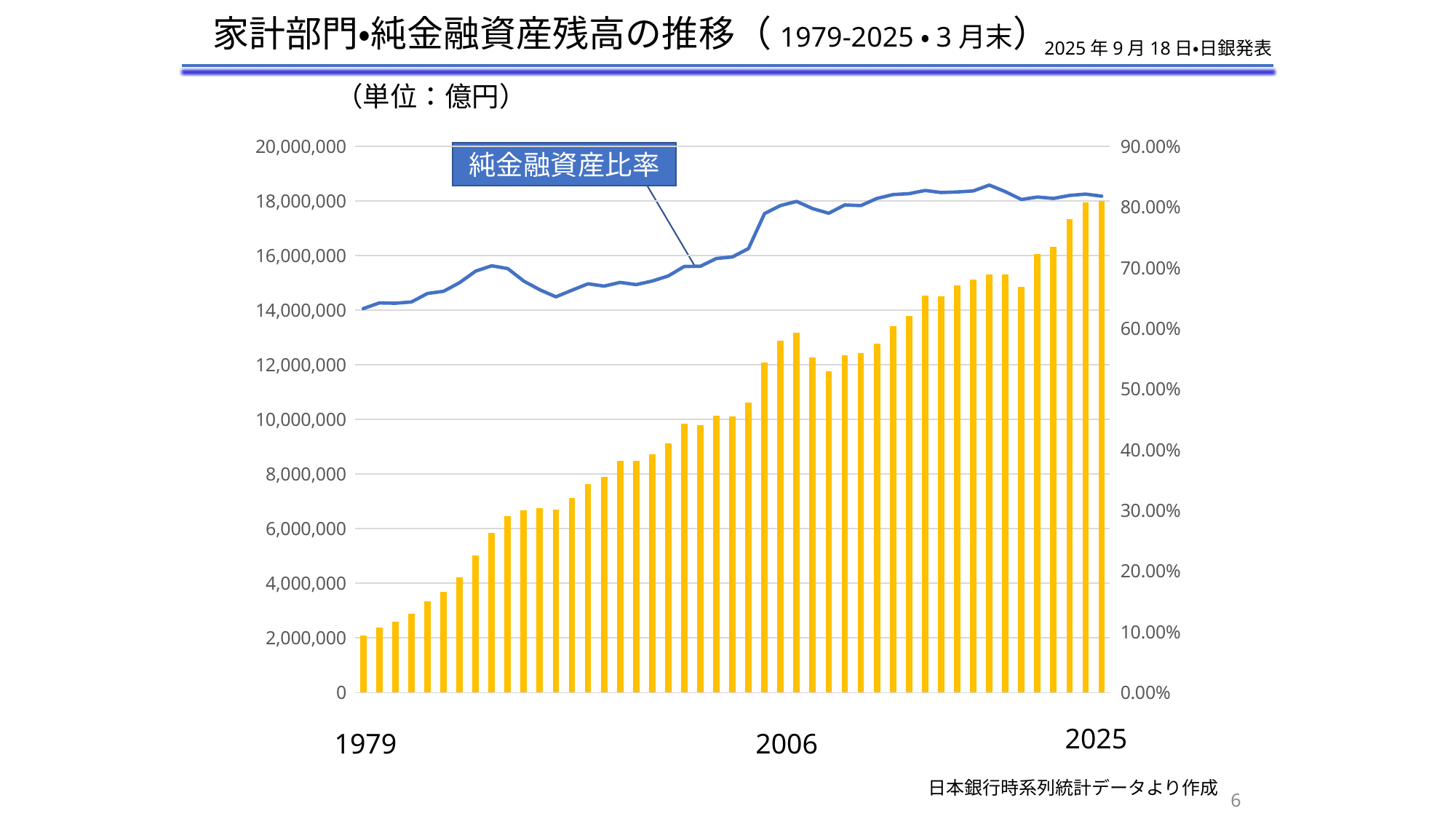
What is the title of the chart? 家計部門•純金融資産残高の推移（1979-2025・3月末） Is the bar for 1979 greater or less than 4,000,000? less Which year has the highest bar (net financial asset balance)? 2025 What kind of chart is shown on the slide? A bar chart combined with a line chart Is the bar for 2006 greater or less than 10,000,000? greater What is the highest value shown on the right-hand (percentage) axis? 90.00% Is the 純金融資産比率 line value for 2025 greater or less than 70.00%? greater What does the blue line on the chart represent, according to the label on the slide? 純金融資産比率 Which year has the lowest bar (net financial asset balance)? 1979 Do the bar values generally rise or fall from 1979 to 2025? rise Which is larger, the bar for 1979 or the bar for 2025? 2025